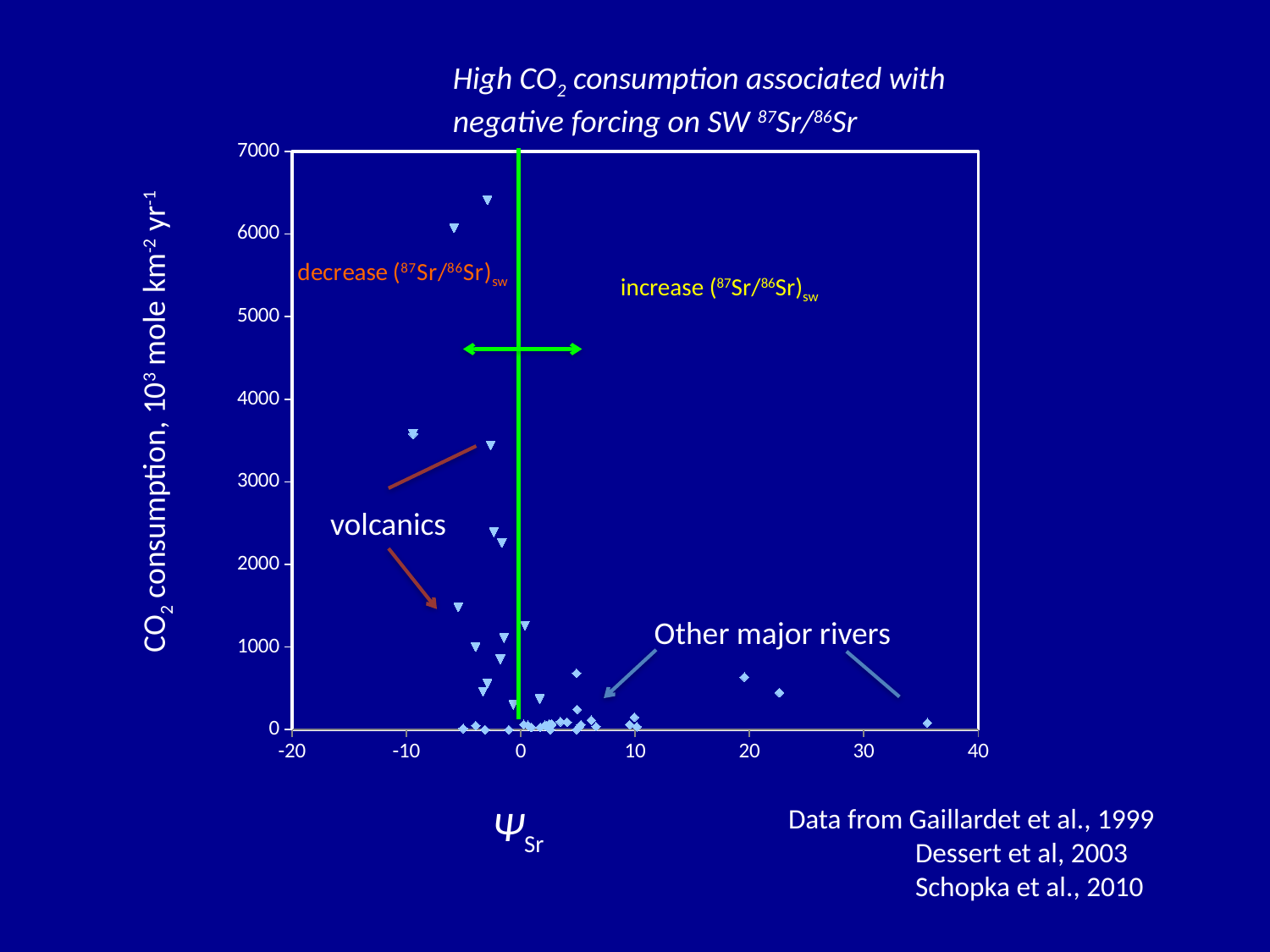
What is the maximum value shown on the y axis? 7000 Is the 'Other major rivers' point near ΨSr = 35 greater or less than 1000 on the y axis? less What kind of chart is shown on the slide? scatter chart Which group of points reaches the highest CO2 consumption values, volcanics or other major rivers? volcanics On which side of the green vertical line at ΨSr = 0 do most of the volcanics points lie? left (negative) How many groups of data points are annotated on the chart? 2 Is the highest volcanics point greater or less than 6000 on the y axis? greater What is the label of the y axis of the chart? CO2 consumption, 10^3 mole km^-2 yr^-1 Is the volcanics point near ΨSr = -10 greater or less than 3000 on the y axis? greater What is the label of the x axis of the chart? ΨSr